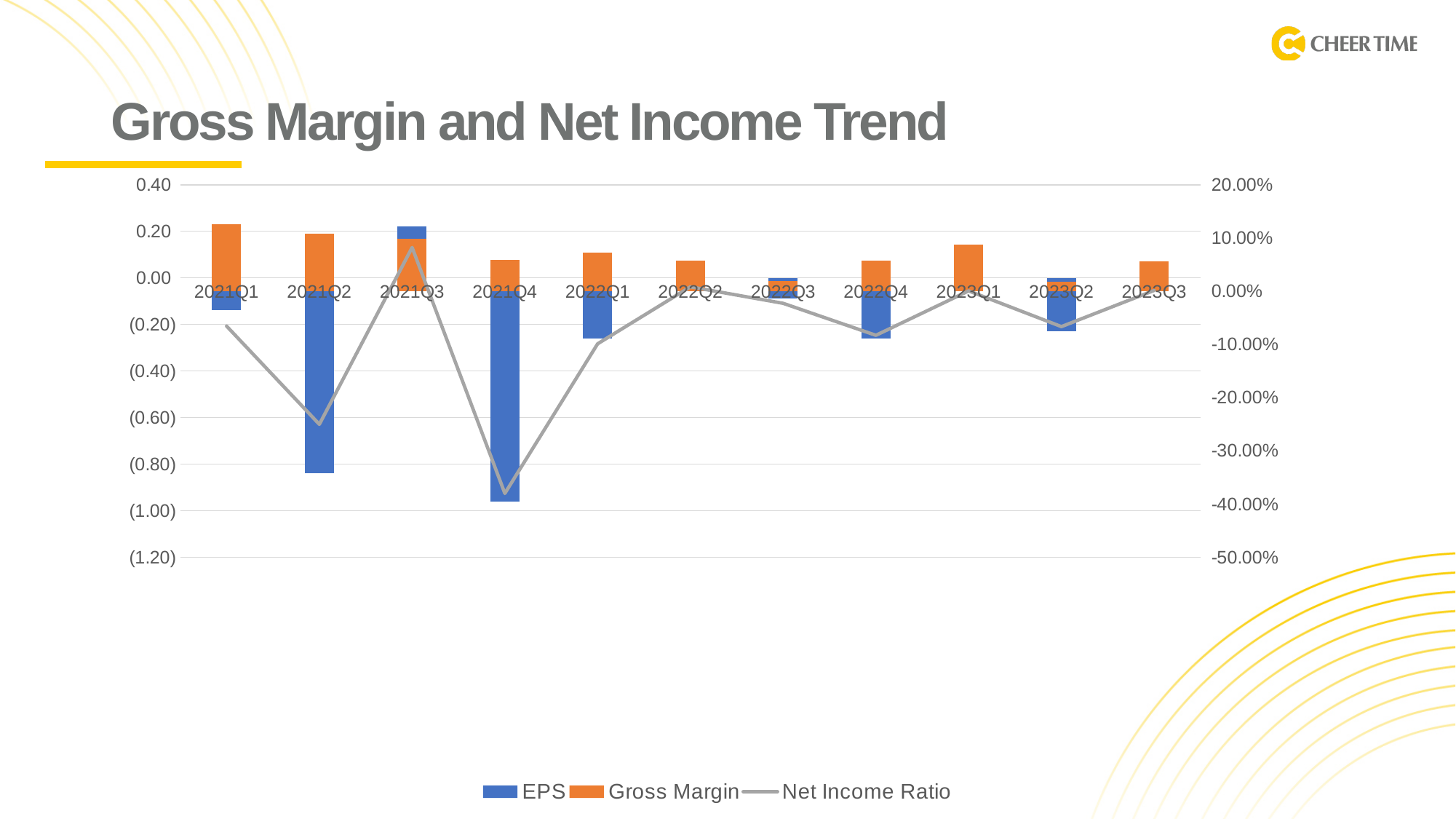
In which quarter is the Net Income Ratio the lowest? 2021Q4 In which quarter is the Net Income Ratio the highest? 2021Q3 In which quarter is EPS the lowest? 2021Q4 Is the EPS value for 2021Q4 greater or less than (0.80)? less In which quarter is Gross Margin the highest? 2021Q1 Is the Net Income Ratio for 2021Q4 greater or less than -30.00%? less What kind of chart is shown on the slide? Combination bar and line chart Which series is plotted as a line in the chart? Net Income Ratio What is the title of the chart on the slide? Gross Margin and Net Income Trend How many series does the chart's legend list? 3 How many quarters are shown on the x axis of the chart? 11